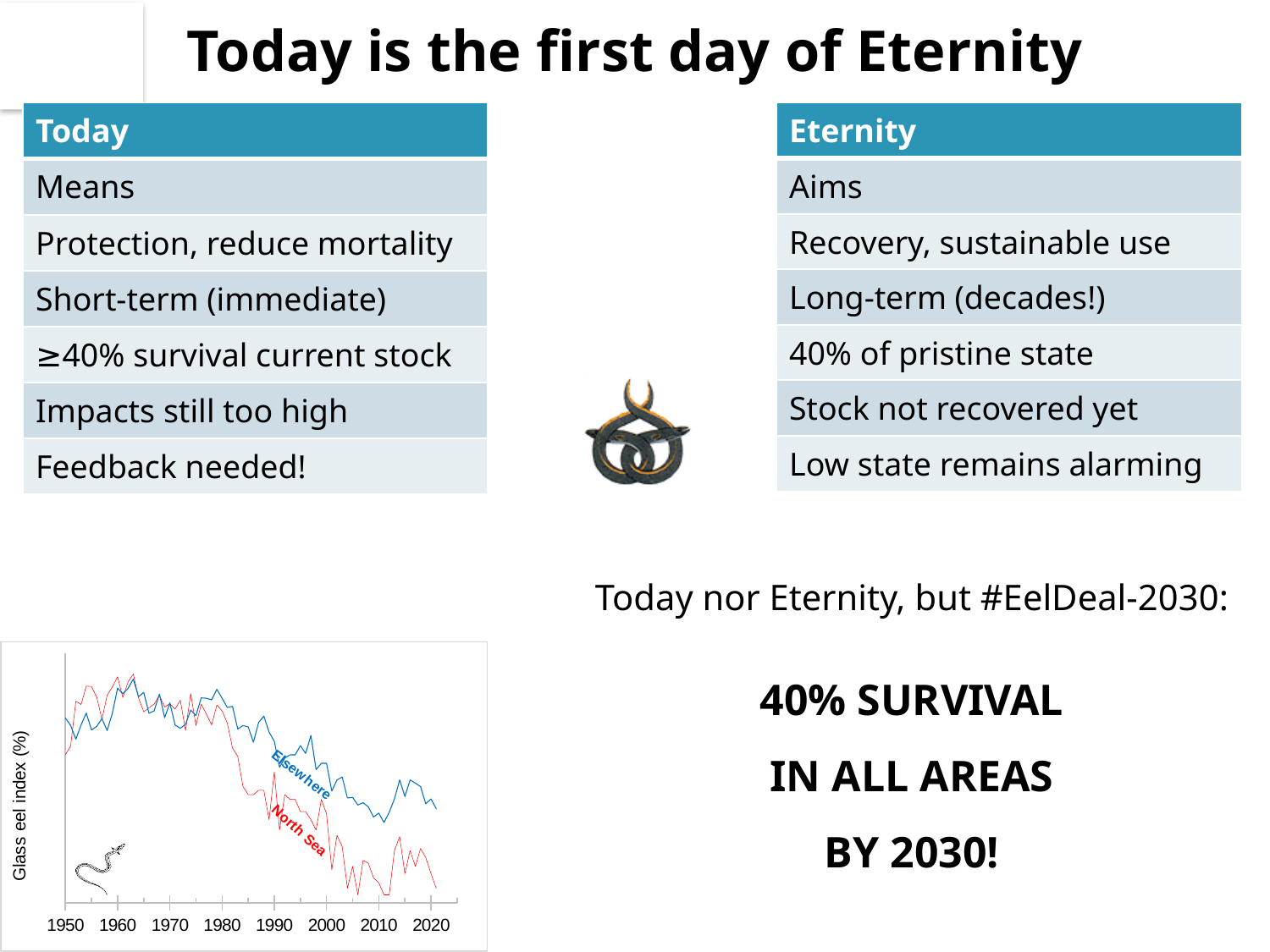
What kind of chart is shown at the bottom left of the slide? line chart Around 2020, which series has the higher glass eel index, Elsewhere or North Sea? Elsewhere How many series are plotted in the glass eel index chart? 2 How many year labels are shown on the x axis of the chart? 8 What is the label on the y axis of the chart? Glass eel index (%) What is the last year labelled on the x axis of the chart? 2020 Does the glass eel index for Elsewhere rise or fall overall from 1980 to 2020? fall Around 2010, which series has the lower glass eel index, Elsewhere or North Sea? North Sea Does the glass eel index for the North Sea rise or fall overall from 1960 to 2020? fall What is the first year labelled on the x axis of the chart? 1950 What are the names of the two series in the glass eel index chart? Elsewhere and North Sea